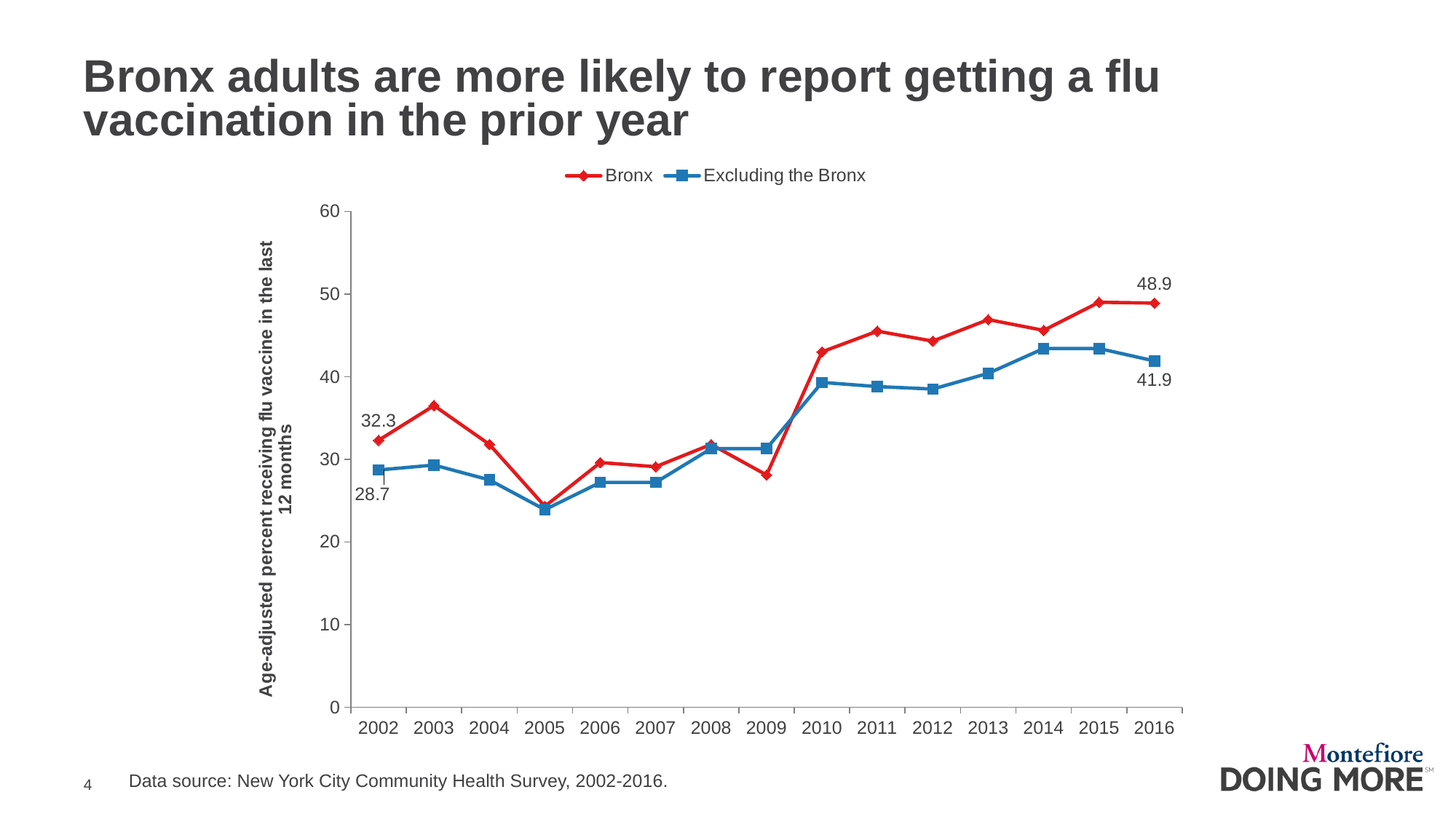
How many years are plotted on the x axis? 15 What is the difference between the Bronx and Excluding the Bronx values in 2016? 7 What is the value for Excluding the Bronx in 2002? 28.7 What is the value for Bronx in 2002? 32.3 What is the value for Bronx in 2016? 48.9 How many series does the legend list? 2 Is the value for Excluding the Bronx in 2010 greater or less than 30? greater Is the value for Bronx in 2005 greater or less than 30? less In which year is the Bronx series at its lowest? 2005 By how much did the Bronx value increase from 2002 to 2016? 16.6 What is the value for Excluding the Bronx in 2016? 41.9 In 2016, which series has the larger value, Bronx or Excluding the Bronx? Bronx